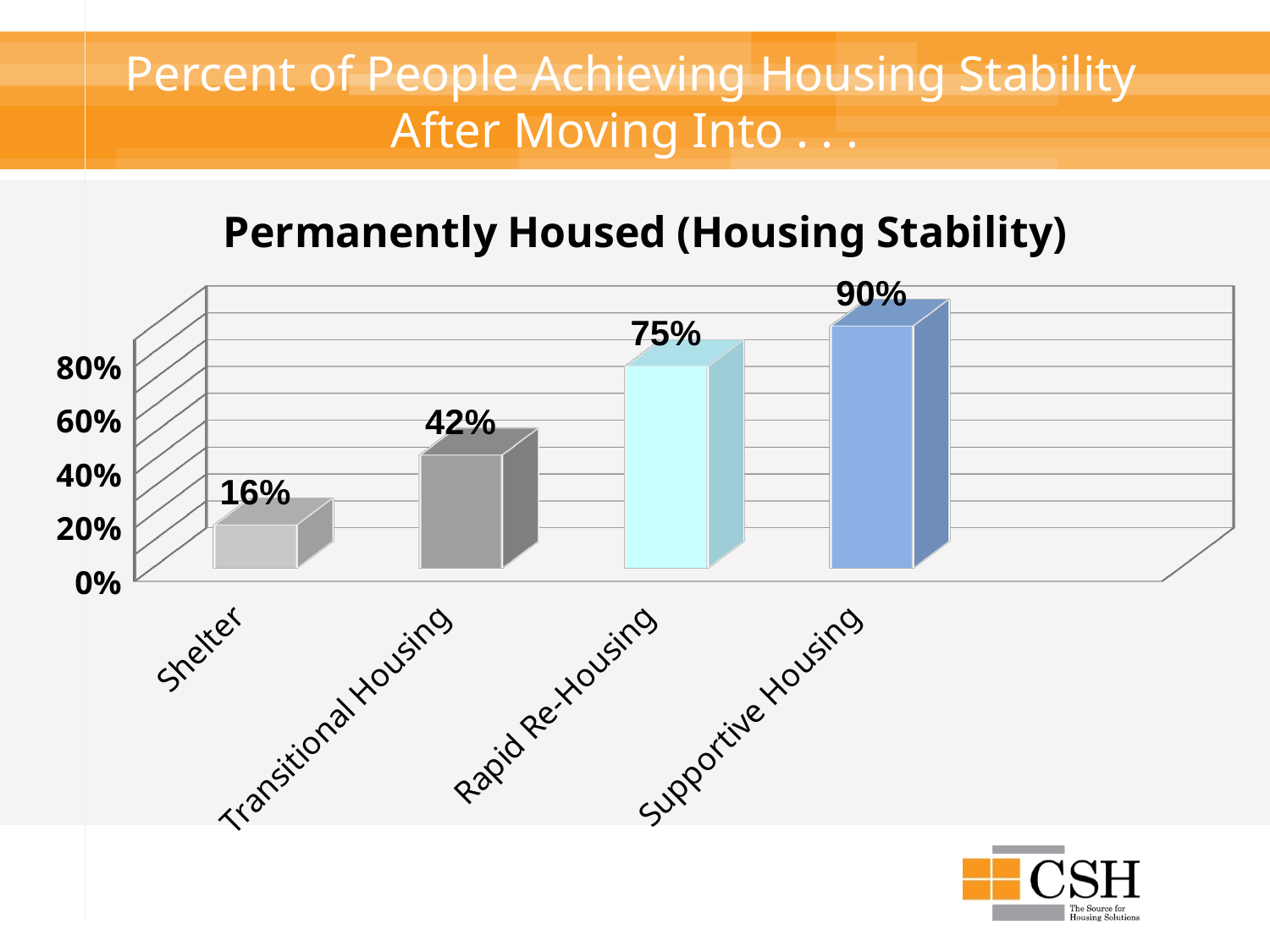
What is the value for Transitional Housing? 42% What is the difference between the values for Rapid Re-Housing and Transitional Housing? 33% How many categories are shown in the chart? 4 Which category has the lowest value? Shelter What kind of chart is shown on the slide? Bar chart Which is larger, the value for Transitional Housing or the value for Rapid Re-Housing? Rapid Re-Housing Which category has the highest value? Supportive Housing What is the value for Shelter? 16% What is the value for Rapid Re-Housing? 75% What is the difference between the values for Supportive Housing and Shelter? 74% Do the values rise or fall from left to right along the x axis? Rise What is the value for Supportive Housing? 90%